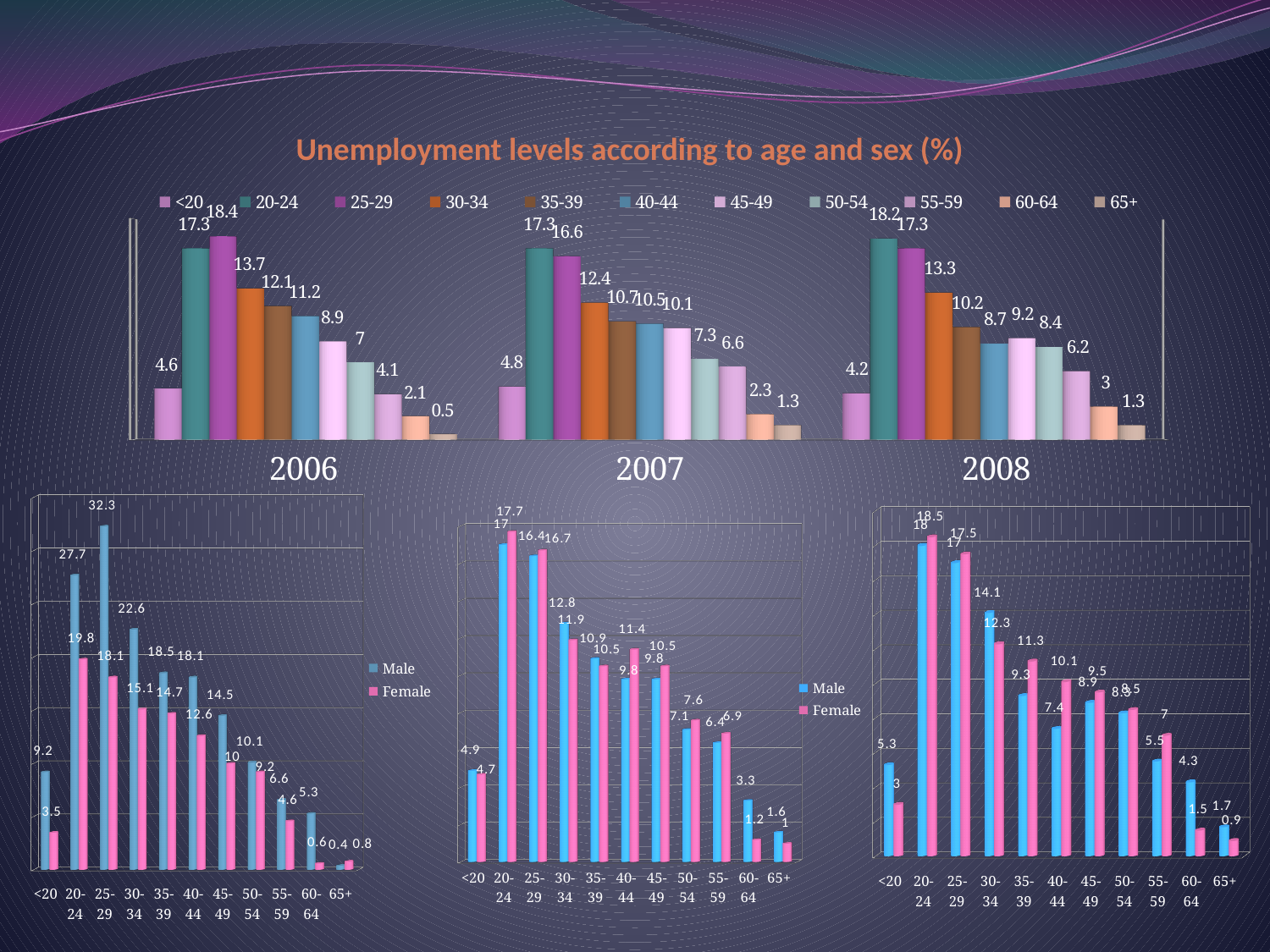
In the top chart, which age group has the lowest value in 2006? 65+ In the bottom-left chart, which is larger for the 20-24 age group, Male or Female? Male In the top chart, which age group has the highest value in 2008? 20-24 In the top chart, what is the unemployment level for the 25-29 age group in 2006? 18.4 In the top chart, what is the difference between the 20-24 and <20 values in 2007? 12.5 In the bottom-middle chart, what is the difference between the Male and Female values for the 60-64 age group? 2.1 What is the title of the top chart? Unemployment levels according to age and sex (%) In the top chart, how many age groups does the legend list? 11 In the bottom-right chart, which age group has the highest Female value? 20-24 What kind of chart is the bottom-right chart? Bar chart In the bottom-middle chart, what is the Female value for the 40-44 age group? 11.4 In the bottom-left chart, what is the Male value for the 25-29 age group? 32.3